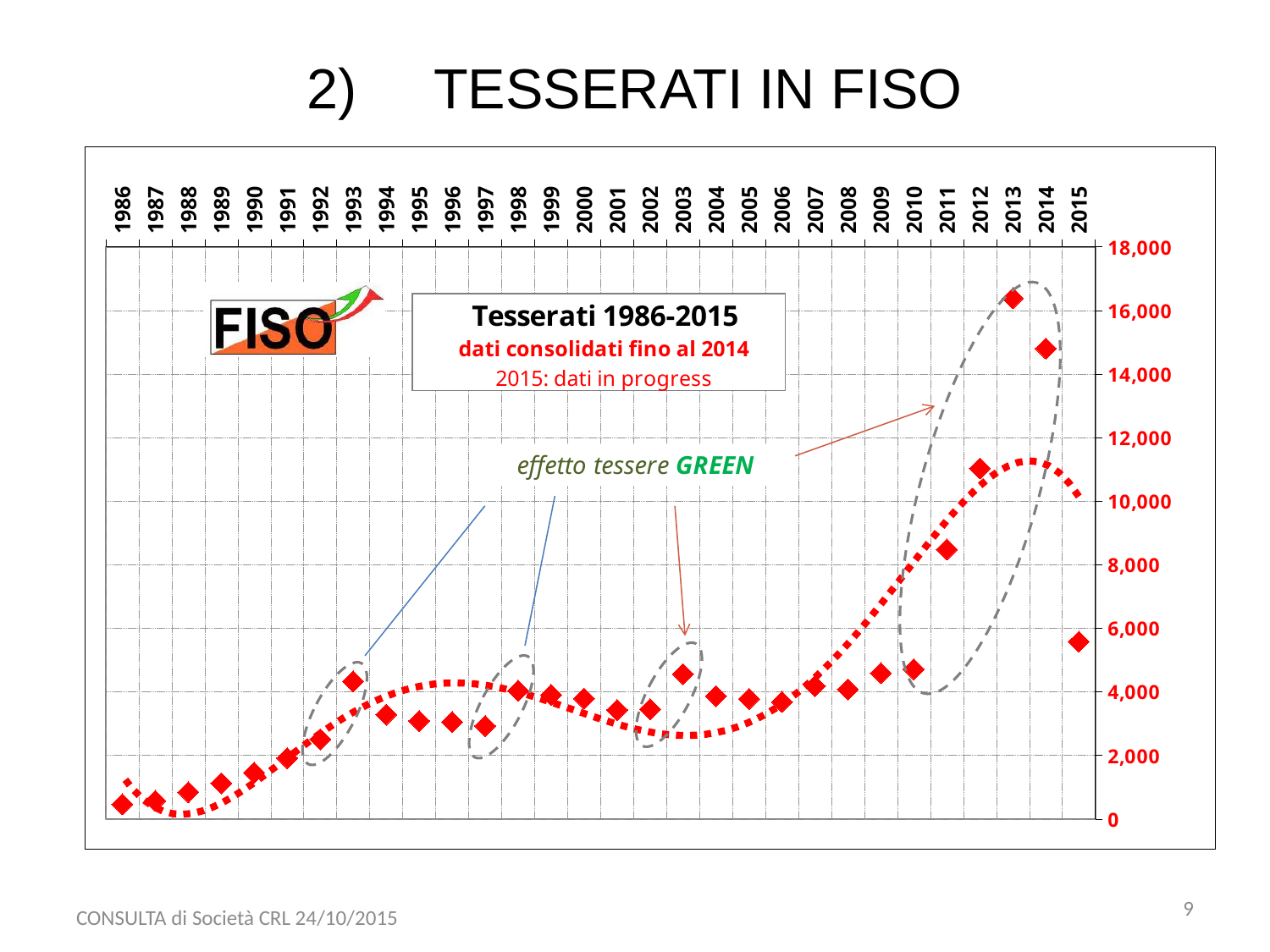
Is the value for 1986 greater or less than 2,000? less Do the values rise or fall from 2010 to 2013? rise Is the value for 2015 greater or less than 6,000? less Is the value for 2013 greater or less than 16,000? greater What kind of chart is shown on the slide? Scatter chart with a dotted trend line Which year has the larger value, 2011 or 2010? 2011 How many years (data points) are plotted on the chart? 30 What is the title shown in the chart's text box? Tesserati 1986-2015 Which year has the highest number of tesserati? 2013 Which year has the larger value, 2013 or 2014? 2013